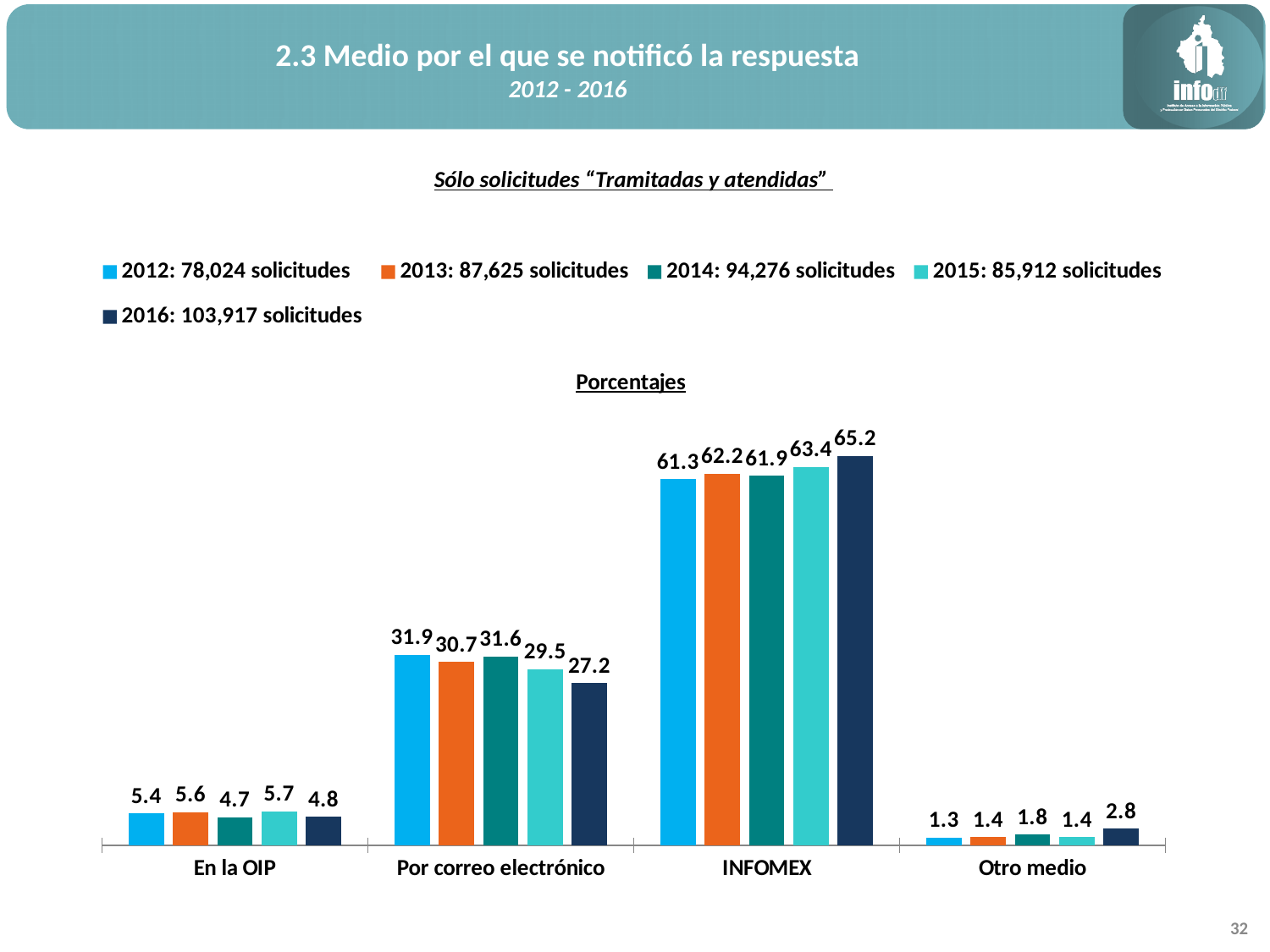
What kind of chart is shown on the slide? bar chart Which category has the highest value in the 2015 series? INFOMEX What is the difference between the 2016 and 2012 values for INFOMEX? 3.9 Do the values for Por correo electrónico rise or fall from 2014 to 2016? fall According to the legend, how many solicitudes were there in 2016? 103,917 What is the value for INFOMEX in the 2016 series? 65.2 How many categories are shown on the x axis? 4 Which category has the lowest value in the 2012 series? Otro medio What is the value for Por correo electrónico in the 2012 series? 31.9 Which is larger for Por correo electrónico: the 2013 value or the 2015 value? 2013 What is the value for Otro medio in the 2014 series? 1.8 How many series does the legend list? 5